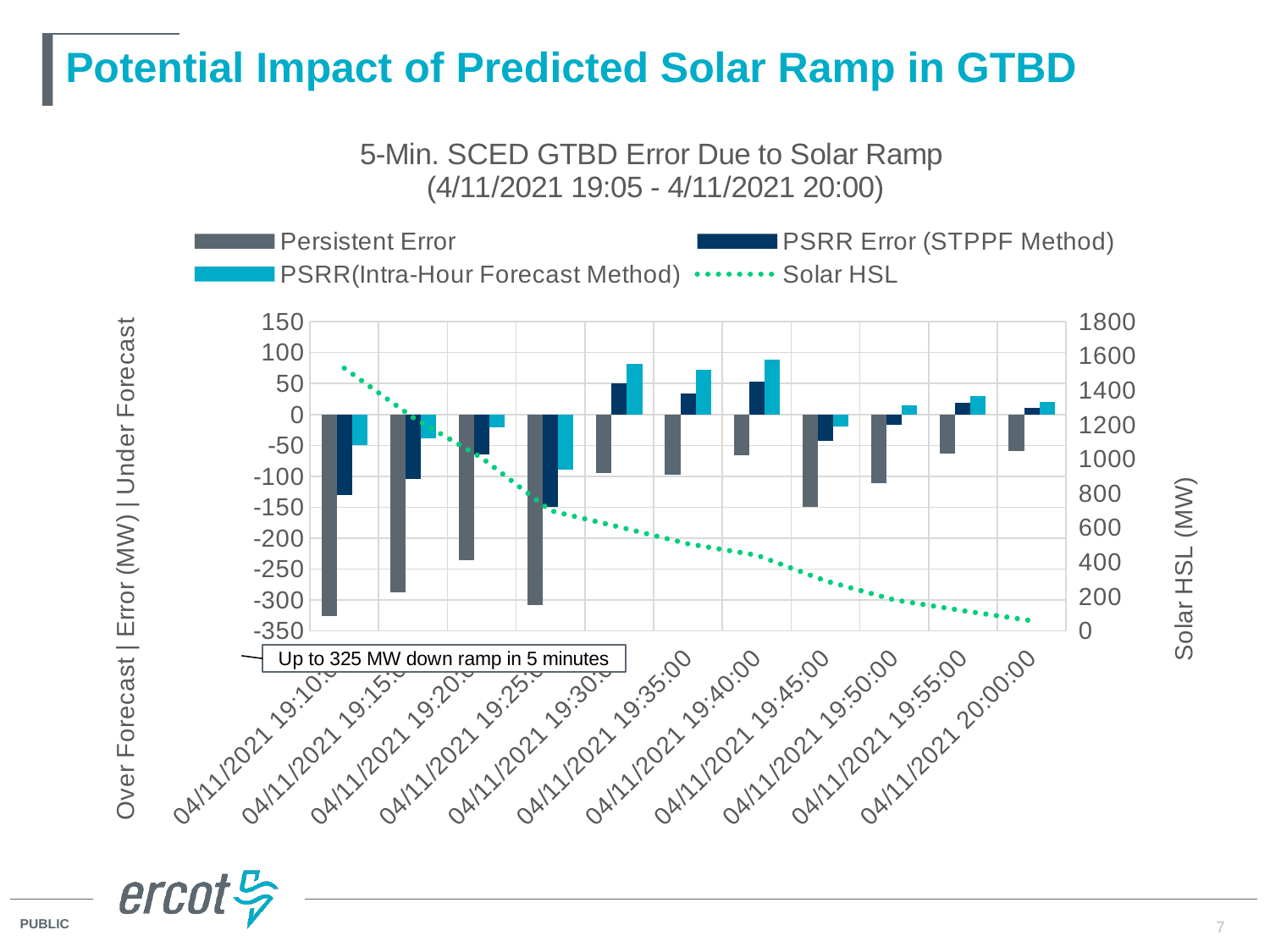
Does the Solar HSL line rise or fall from left to right along the x axis? Fall Is the Solar HSL value at 04/11/2021 19:10:00 greater or less than 1400? greater Which series is drawn as a dotted line? Solar HSL What is the title of the chart? 5-Min. SCED GTBD Error Due to Solar Ramp (4/11/2021 19:05 - 4/11/2021 20:00) How many time categories are shown on the x axis? 11 Is the PSRR(Intra-Hour Forecast Method) value at 04/11/2021 19:40:00 greater or less than 50? greater What kind of chart is this? Bar chart with a dotted line Is the Persistent Error value at 04/11/2021 19:10:00 greater or less than -300? less At 04/11/2021 19:10:00, which series has the more negative value, Persistent Error or PSRR Error (STPPF Method)? Persistent Error How many series does the chart legend list? 4